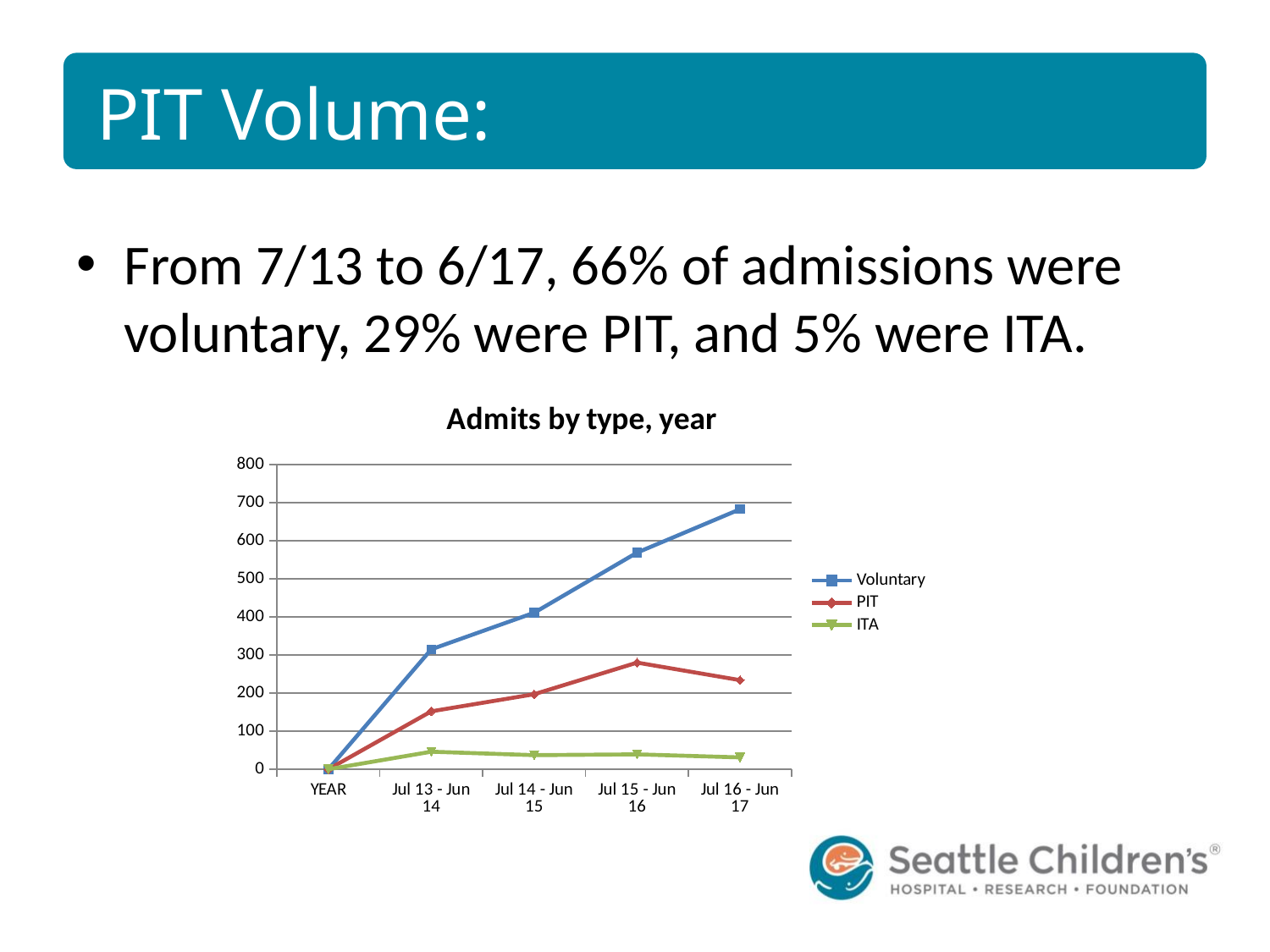
Which series has the larger value in Jul 15 - Jun 16, Voluntary or PIT? Voluntary Which series are listed in the chart's legend? Voluntary, PIT, ITA Is the Voluntary value for Jul 16 - Jun 17 greater or less than 600? greater In which period does the PIT series reach its highest value? Jul 15 - Jun 16 How many series does the chart's legend list? 3 In which period does the Voluntary series reach its highest value? Jul 16 - Jun 17 Does the Voluntary series rise or fall from Jul 13 - Jun 14 to Jul 16 - Jun 17? rise Is the ITA value for Jul 13 - Jun 14 greater or less than 100? less How many points are plotted along the x axis for each series? 5 Is the PIT value for Jul 14 - Jun 15 greater or less than 300? less What is the title of the chart? Admits by type, year What kind of chart is shown on the slide? line chart